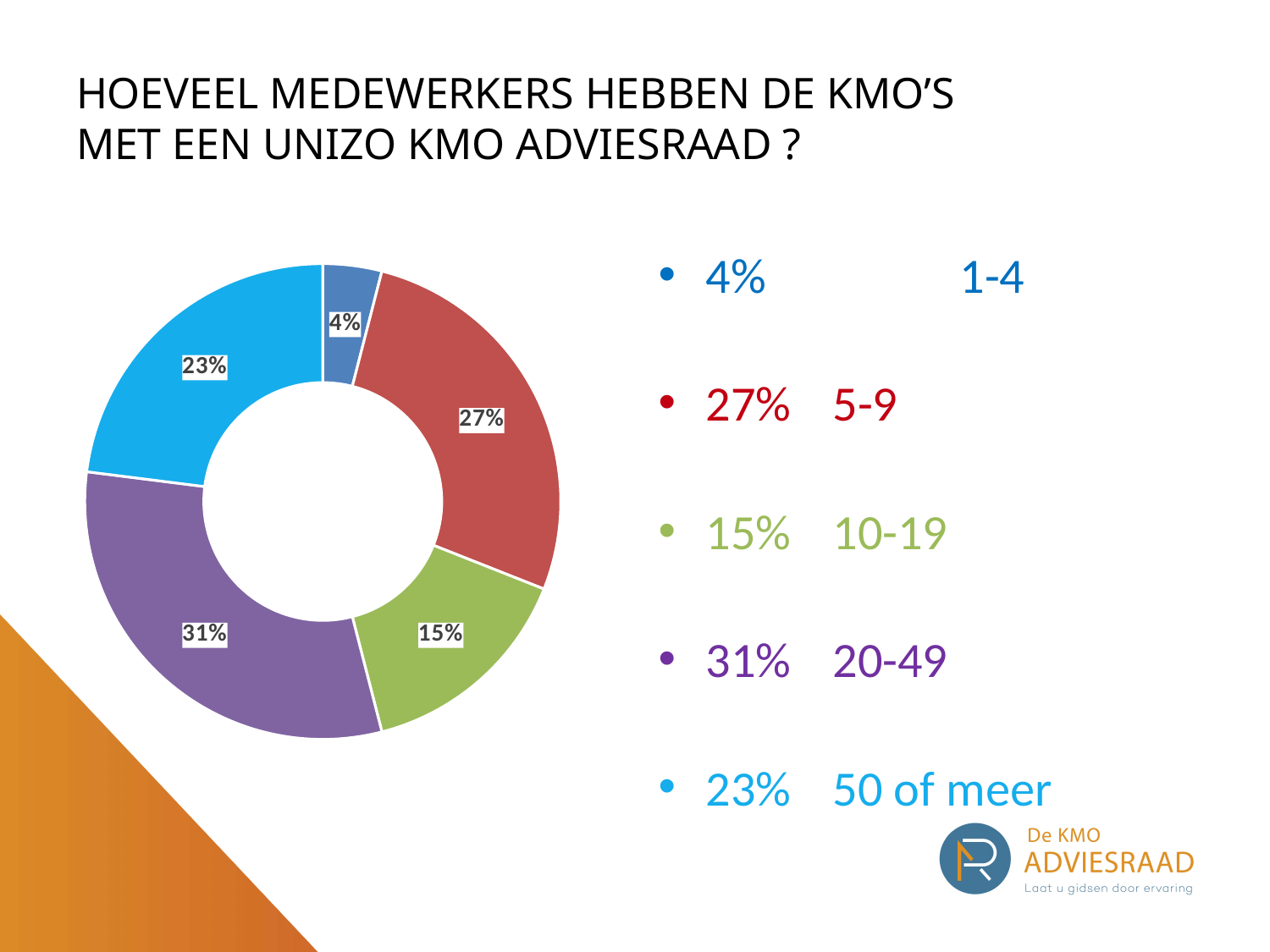
How many slices does the doughnut chart have? 5 What kind of chart is shown on the slide? doughnut chart Which employee category has the largest share of the doughnut chart? 20-49 Which is larger, the share for 5-9 employees or the share for 50 of meer employees? 5-9 What share of the doughnut chart is labelled for the 20-49 employee category? 31% Which employee category has the smallest share of the doughnut chart? 1-4 What percentage is shown for the 1-4 employee category? 4% Which colour represents the 20-49 employee category in the doughnut chart? purple What is the difference in percentage points between the 20-49 category and the 1-4 category? 27 What percentage is shown for the 10-19 employee category? 15% What percentage is shown for the 50 of meer category? 23% What is the difference in percentage points between the 5-9 category and the 10-19 category? 12